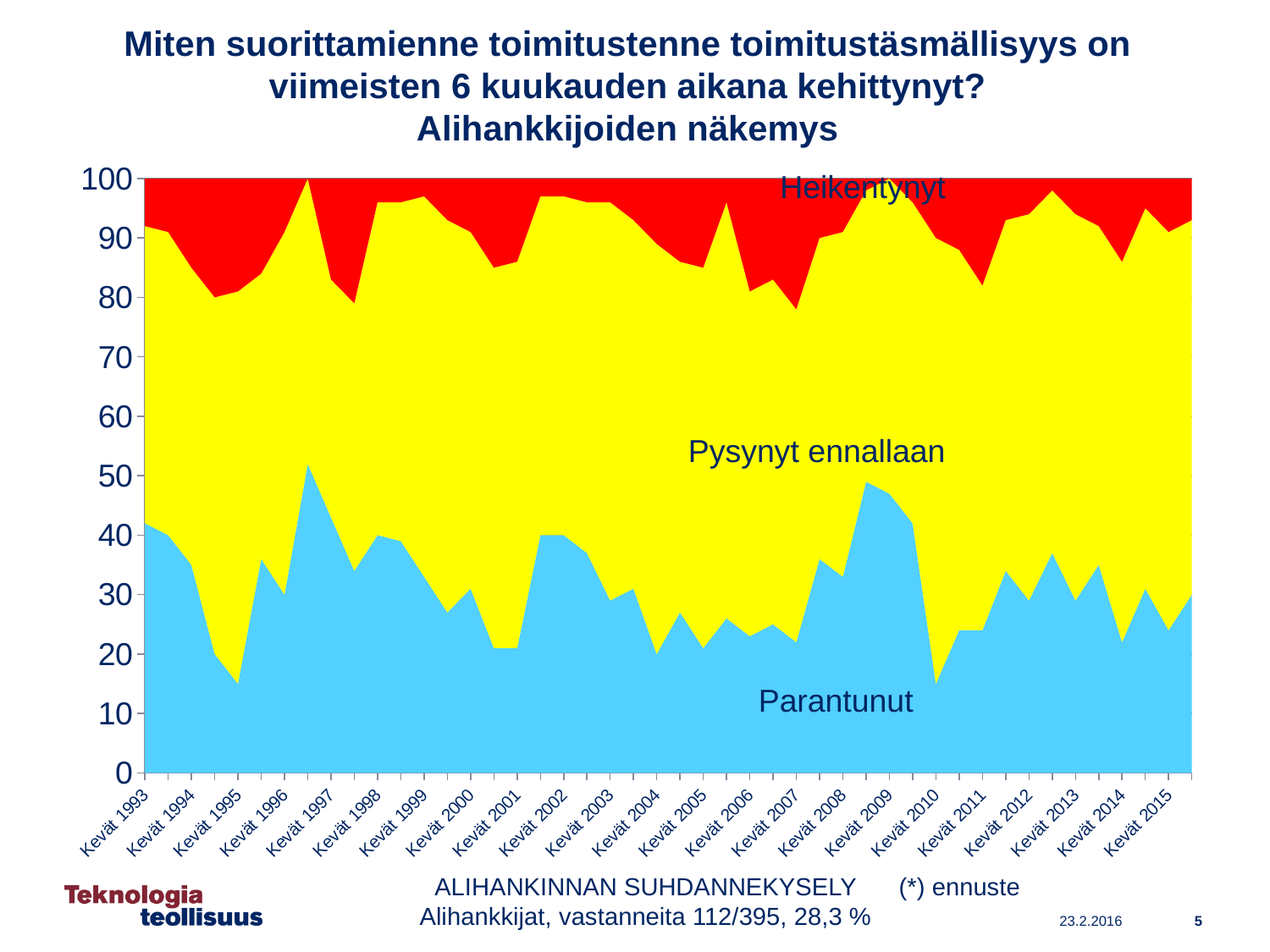
Is the value for Parantunut at Kevät 1993 greater or less than 30? greater Which series occupies the largest area in the chart? Pysynyt ennallaan What kind of chart is shown on the slide? Stacked area chart Does the Parantunut value rise or fall from Kevät 2009 to Kevät 2010? Fall Is the value for Parantunut at Kevät 2010 greater or less than 20? less Is the value for Parantunut at Kevät 2009 greater or less than 40? greater Which series is drawn at the top of the stacked area chart? Heikentynyt How many year labels are shown on the x axis of the chart? 23 Which is larger, the Parantunut value at Kevät 1997 or at Kevät 1995? Kevät 1997 How many series are plotted in the chart? 3 What colour is the Parantunut area in the chart? Blue